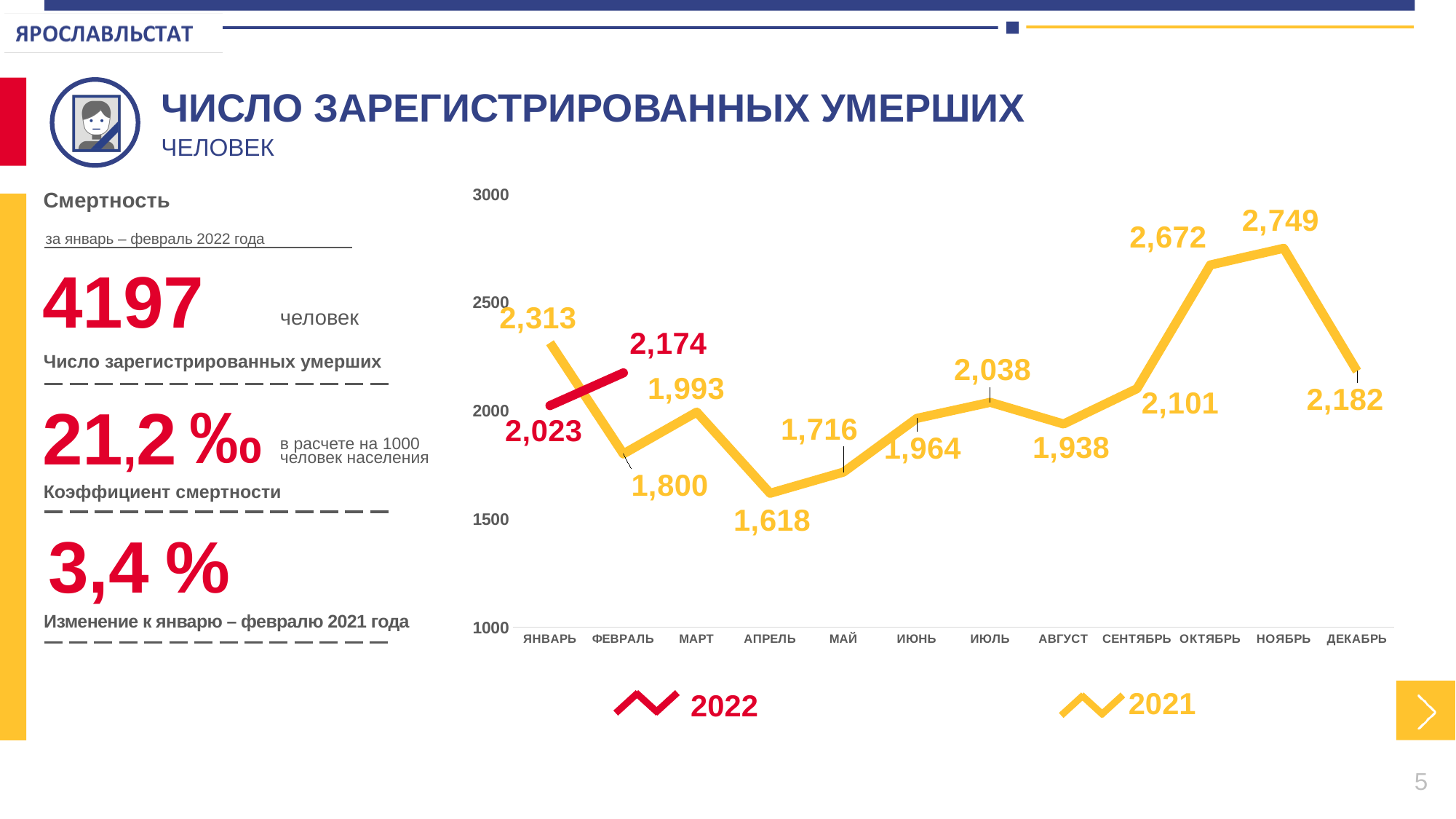
What is the value for 2021 in АПРЕЛЬ? 1,618 How many months are shown on the x axis? 12 What is the value for 2022 in ФЕВРАЛЬ? 2,174 Is the 2021 value for ОКТЯБРЬ greater or less than 2500? greater Which is larger in ЯНВАРЬ: the 2021 value or the 2022 value? 2021 Does the 2021 series rise or fall from СЕНТЯБРЬ to НОЯБРЬ? rise What kind of chart is shown on the slide? line chart How many series does the legend list? 2 What is the value for 2021 in ЯНВАРЬ? 2,313 What is the difference between the 2022 and 2021 values in ФЕВРАЛЬ? 374 Which month has the lowest value for the 2021 series? АПРЕЛЬ Which month has the highest value for the 2021 series? НОЯБРЬ